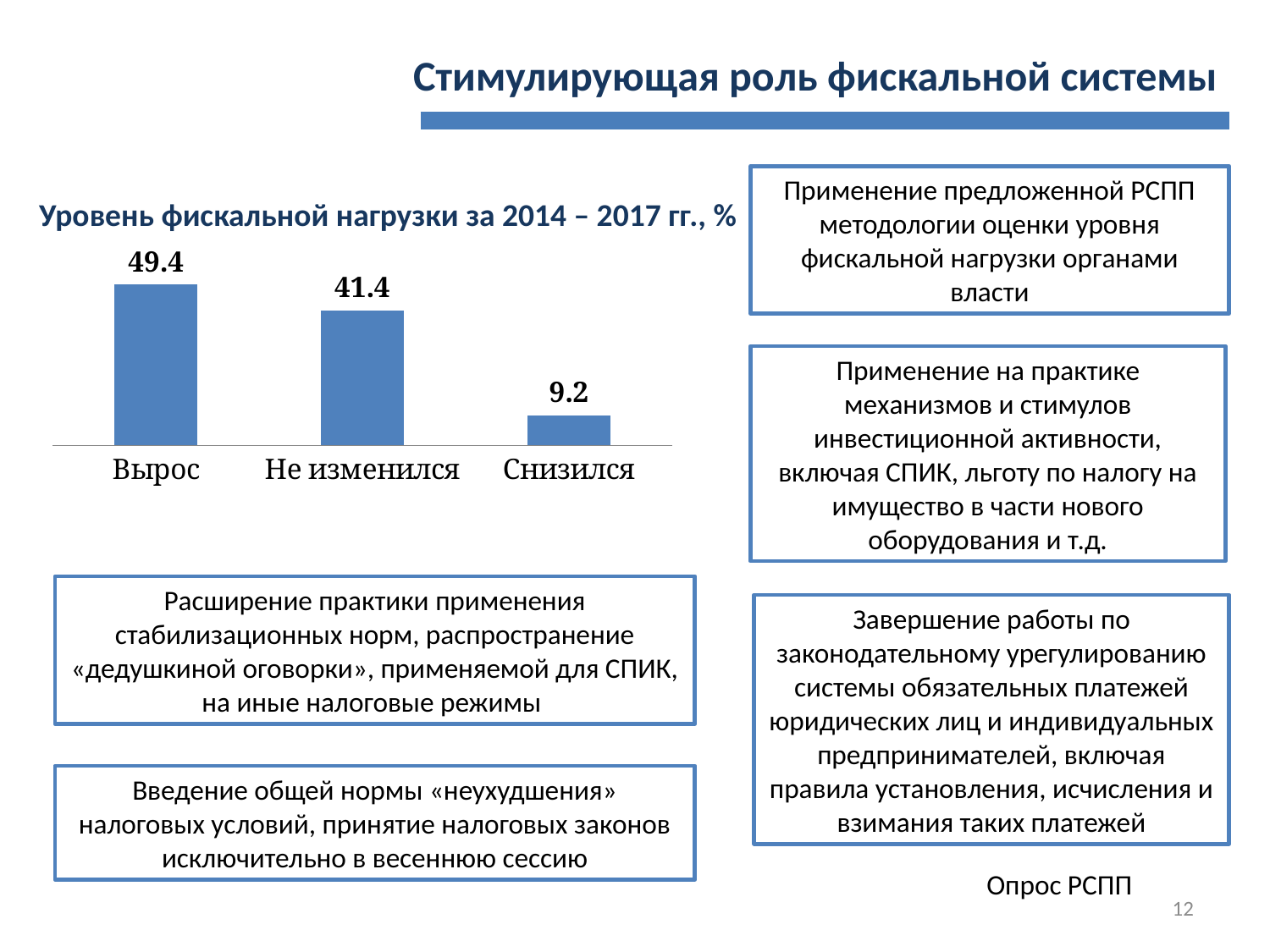
What is the difference between the values for "Не изменился" and "Снизился"? 32.2 Do the values rise or fall from left to right across the categories? fall How many categories are shown in the chart? 3 Which is larger, the value for "Вырос" or the value for "Снизился"? Вырос Which category has the lowest value? Снизился What is the value for the category "Снизился"? 9.2 Which category has the highest value? Вырос What kind of chart is shown on the slide? bar chart What is the title of the chart? Уровень фискальной нагрузки за 2014 – 2017 гг., % What is the value for the category "Не изменился"? 41.4 What is the difference between the values for "Вырос" and "Не изменился"? 8 What is the value for the category "Вырос"? 49.4